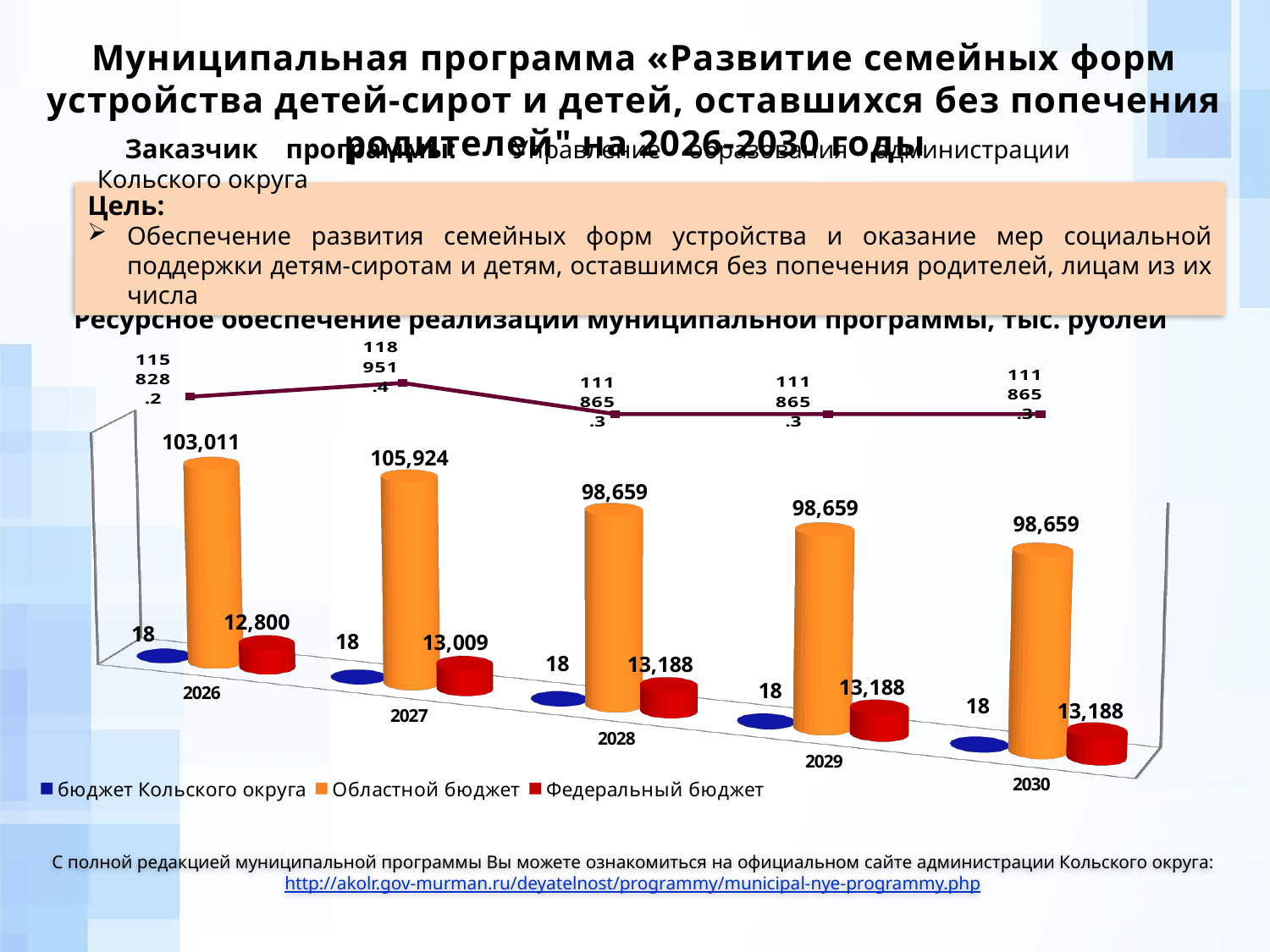
What is the value for Областной бюджет in 2027? 105,924 What is the value for бюджет Кольского округа in 2029? 18 Which is larger: Федеральный бюджет in 2027 or Федеральный бюджет in 2028? Федеральный бюджет in 2028 How many series does the legend list? 3 What is the value for Федеральный бюджет in 2026? 12,800 What kind of chart is used to show the budget values? bar chart What is the value for Федеральный бюджет in 2030? 13,188 In which year is the Областной бюджет value highest? 2027 How many years are shown on the x axis of the chart? 5 What is the difference between the Областной бюджет values for 2027 and 2026? 2,913 In which year is the Федеральный бюджет value lowest? 2026 What is the title of the chart? Ресурсное обеспечение реализации муниципальной программы, тыс. рублей